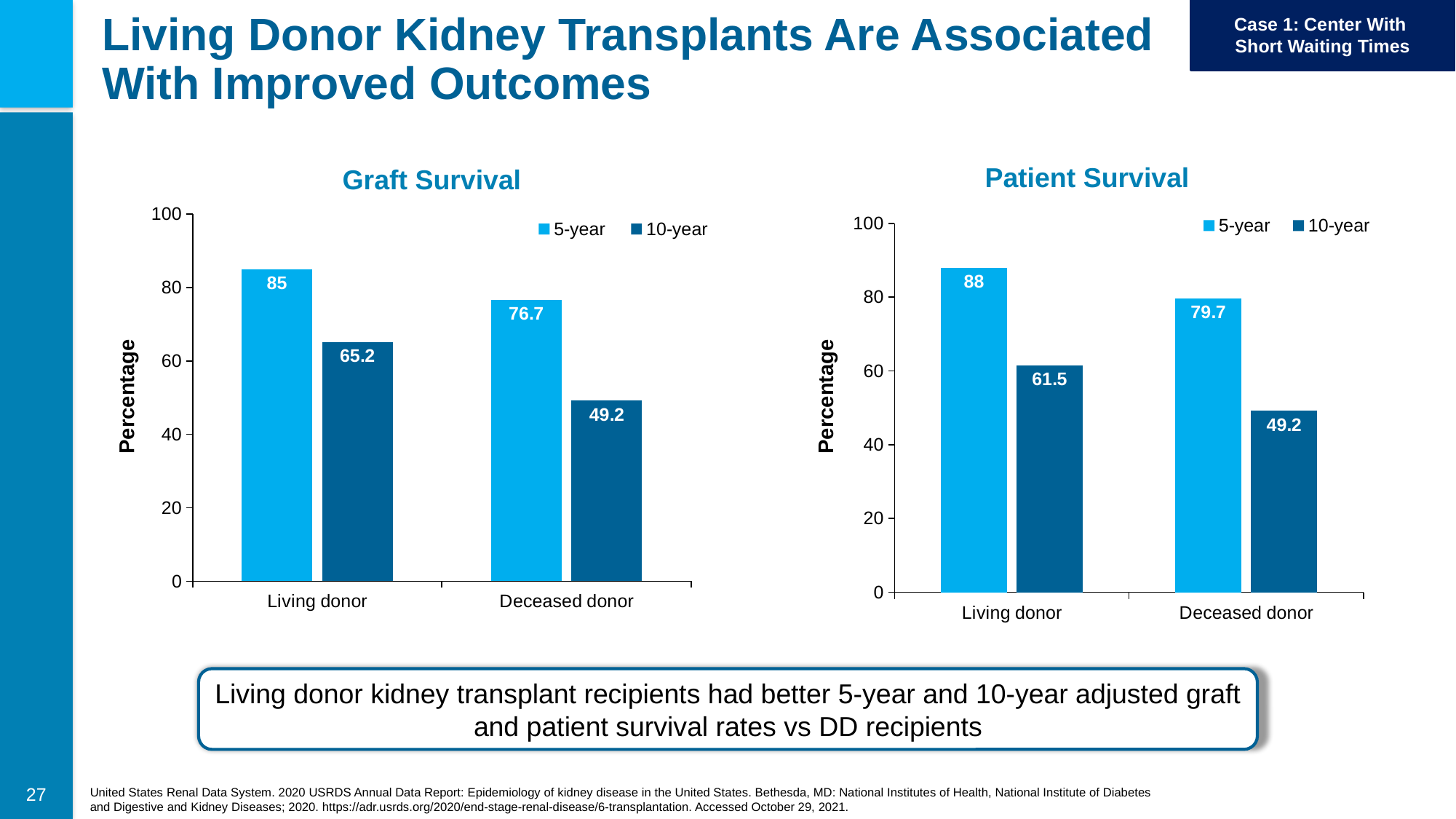
In the Patient Survival chart, what is the difference between the 10-year values for Living donor and Deceased donor? 12.3 In the Graft Survival chart, what is the 5-year value for Living donor? 85 In the Patient Survival chart, what is the 10-year value for Living donor? 61.5 In the Graft Survival chart, what is the difference between the 5-year values for Living donor and Deceased donor? 8.3 How many categories are shown on the x axis of the Patient Survival chart? 2 In the Patient Survival chart, which is larger: the 5-year value for Deceased donor or the 10-year value for Living donor? 5-year value for Deceased donor In the Graft Survival chart, which bar has the highest value? Living donor, 5-year How many series does the legend of the Graft Survival chart list? 2 In the Patient Survival chart, what is the 5-year value for Living donor? 88 In the Patient Survival chart, which bar has the lowest value? Deceased donor, 10-year In the Graft Survival chart, what is the 10-year value for Deceased donor? 49.2 What type of chart is the Graft Survival chart? Bar chart